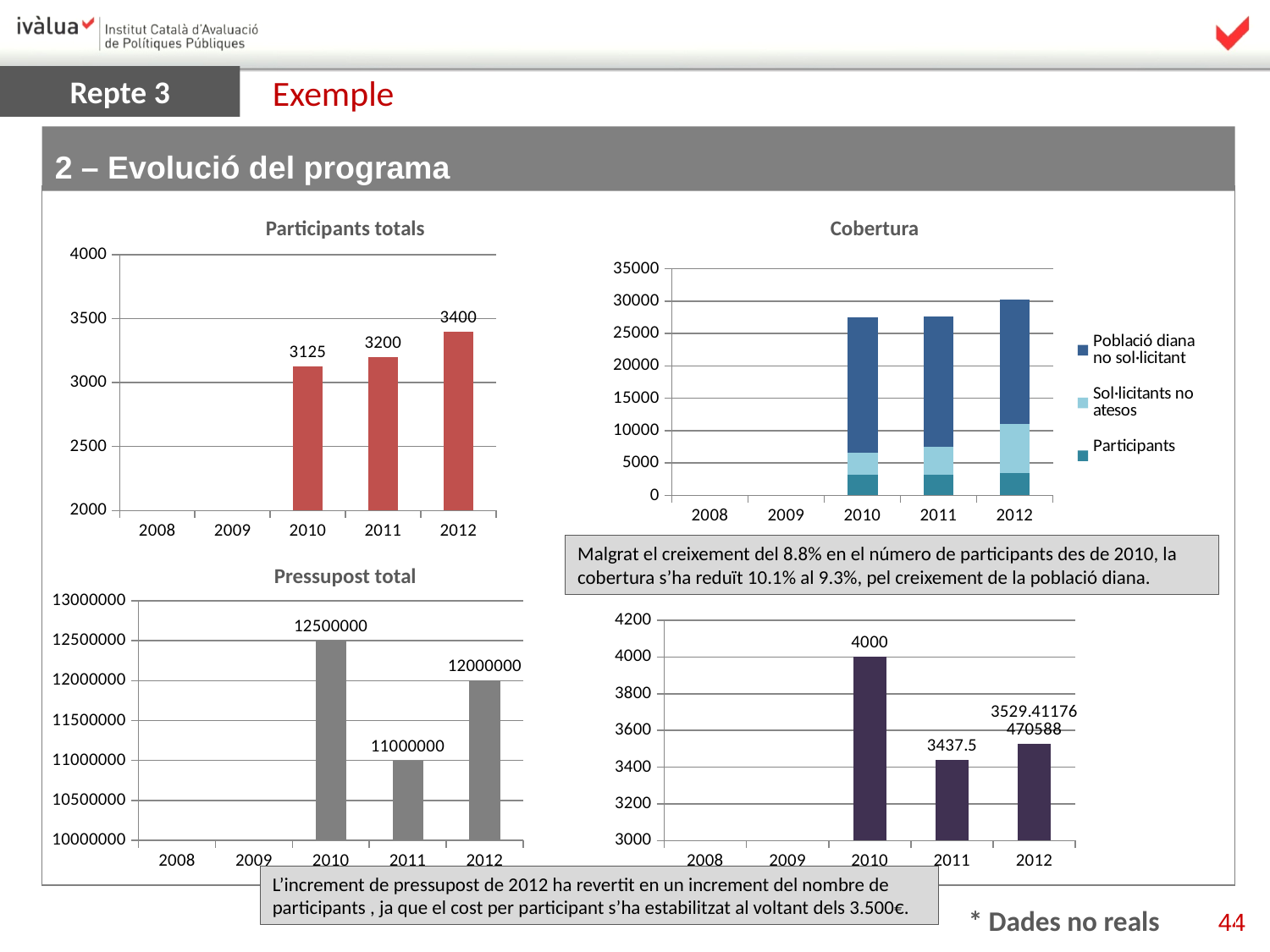
In the 'Pressupost total' chart, what is the difference between the 2010 and 2011 values? 1500000 In the untitled chart at the bottom right, what is the value for 2011? 3437.5 In the 'Cobertura' chart, is the total stacked value for 2010 greater or less than 30000? less In the untitled chart at the bottom right, which year has the highest value? 2010 How many series does the legend of the 'Cobertura' chart list? 3 In the 'Pressupost total' chart, what is the value for 2011? 11000000 In the 'Participants totals' chart, which year has the highest value? 2012 In the 'Participants totals' chart, what is the difference between the 2012 and 2010 values? 275 In the 'Participants totals' chart, do the values rise or fall from 2010 to 2012? rise In the 'Pressupost total' chart, which year has the lowest value? 2011 In the 'Participants totals' chart, what is the value for 2012? 3400 What kind of chart is the 'Cobertura' chart? stacked bar chart